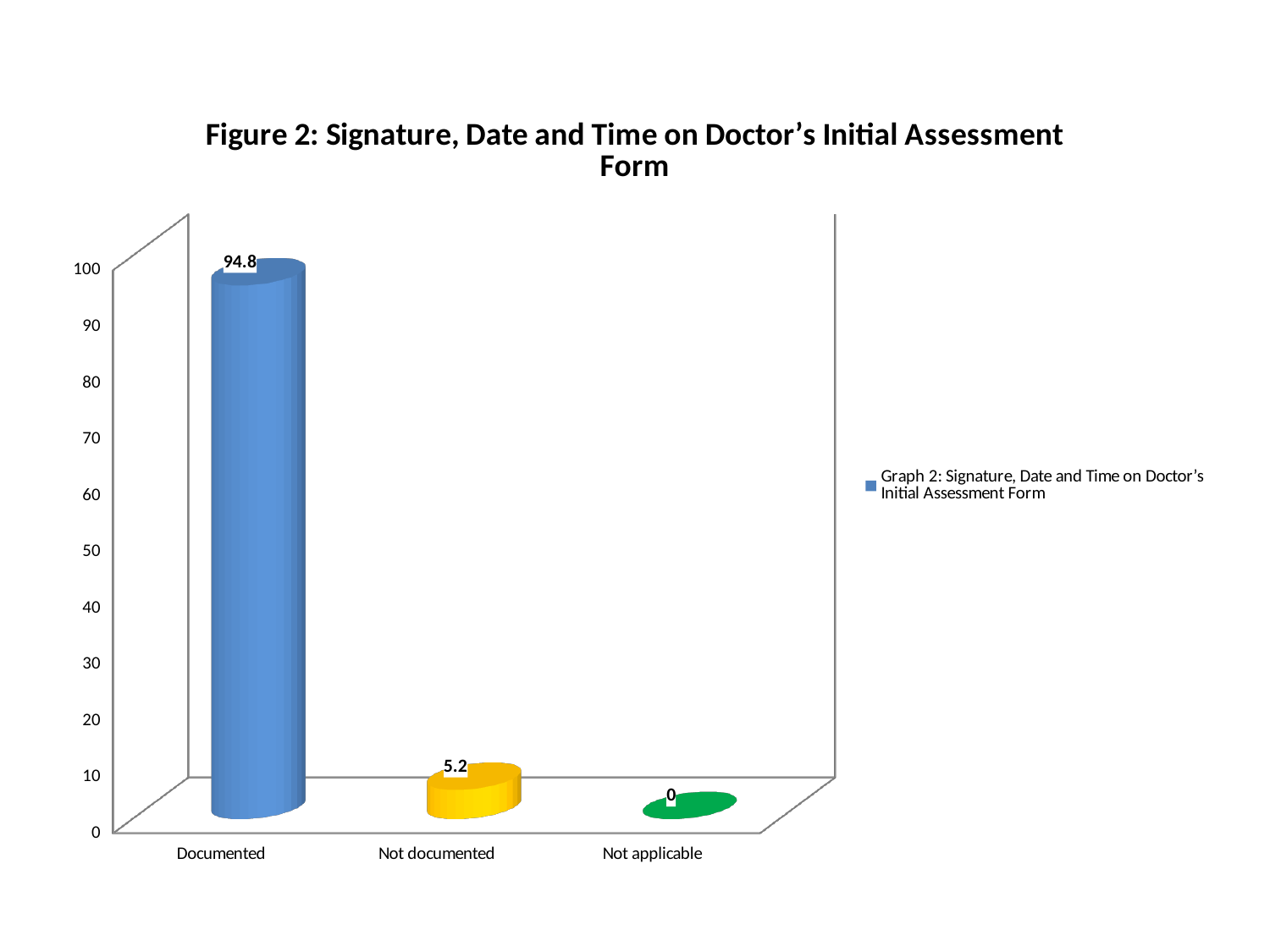
What is the value for Not applicable? 0 How many series does the legend list? 1 What is the difference between the values for Documented and Not documented? 89.6 Which category has the highest value? Documented Which is larger, the value for Not documented or the value for Not applicable? Not documented What is the value for Not documented? 5.2 What kind of chart is shown on the slide? Bar chart What is the title of the chart? Figure 2: Signature, Date and Time on Doctor's Initial Assessment Form Which category has the lowest value? Not applicable Is the value for Documented greater or less than 90? greater What is the value for Documented? 94.8 How many categories are shown on the x axis? 3